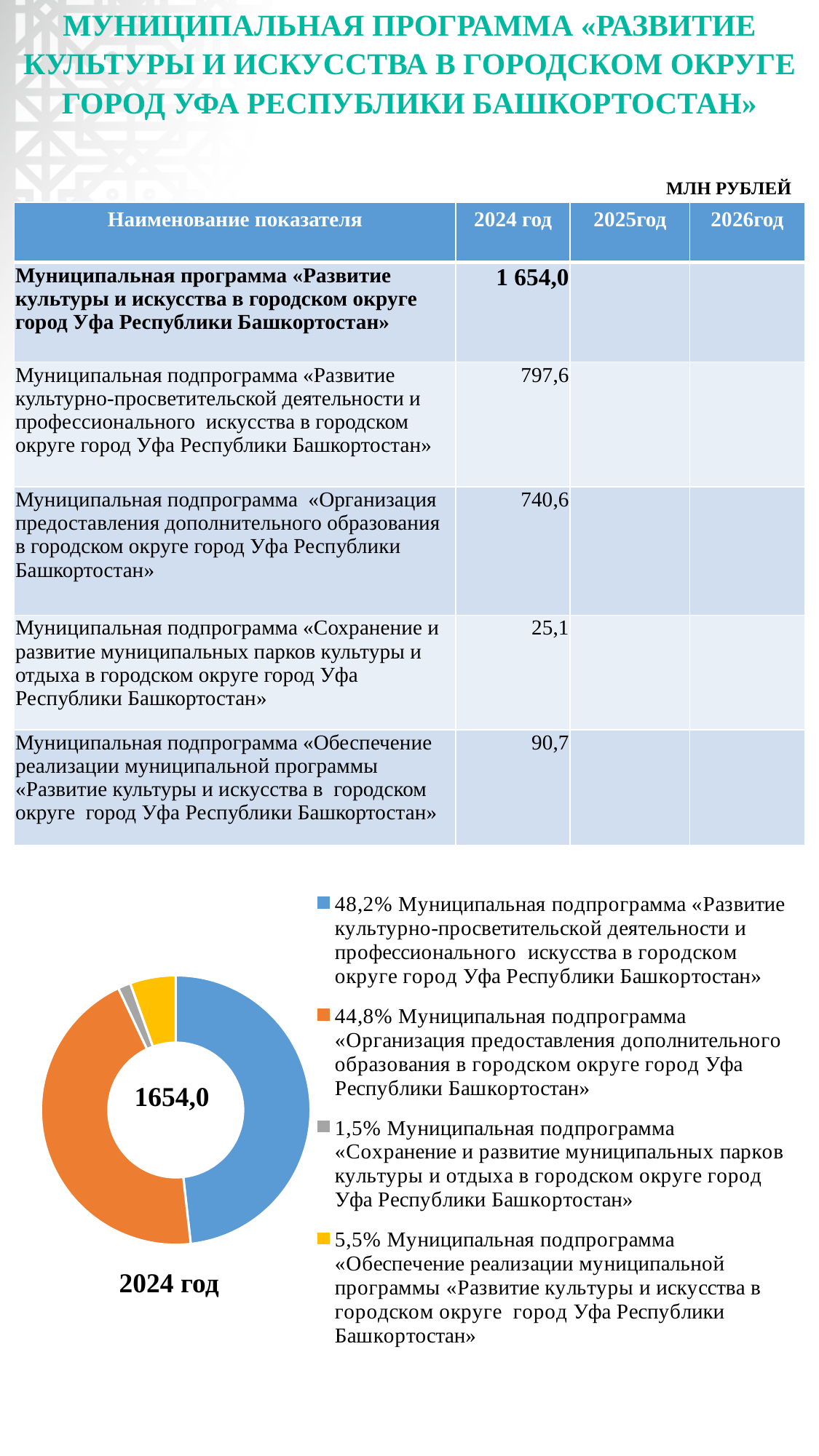
What share of the doughnut chart does the subprogram «Обеспечение реализации муниципальной программы» have? 5,5% How many slices does the doughnut chart have? 4 What is the difference in percentage points between the 48,2% slice and the 44,8% slice? 3,4 What share of the doughnut chart does the subprogram «Развитие культурно-просветительской деятельности и профессионального искусства» have? 48,2% Which subprogram has the smallest slice in the doughnut chart? Муниципальная подпрограмма «Сохранение и развитие муниципальных парков культуры и отдыха в городском округе город Уфа Республики Башкортостан» What share of the doughnut chart does the subprogram «Организация предоставления дополнительного образования» have? 44,8% What year is labelled beneath the doughnut chart? 2024 год What kind of chart is shown on the slide? Doughnut (pie) chart Which slice is larger: the one for «Обеспечение реализации муниципальной программы» or the one for «Сохранение и развитие муниципальных парков»? «Обеспечение реализации муниципальной программы» (5,5%) Which subprogram has the largest slice in the doughnut chart? Муниципальная подпрограмма «Развитие культурно-просветительской деятельности и профессионального искусства в городском округе город Уфа Республики Башкортостан» What total value is printed in the centre of the doughnut chart? 1654,0